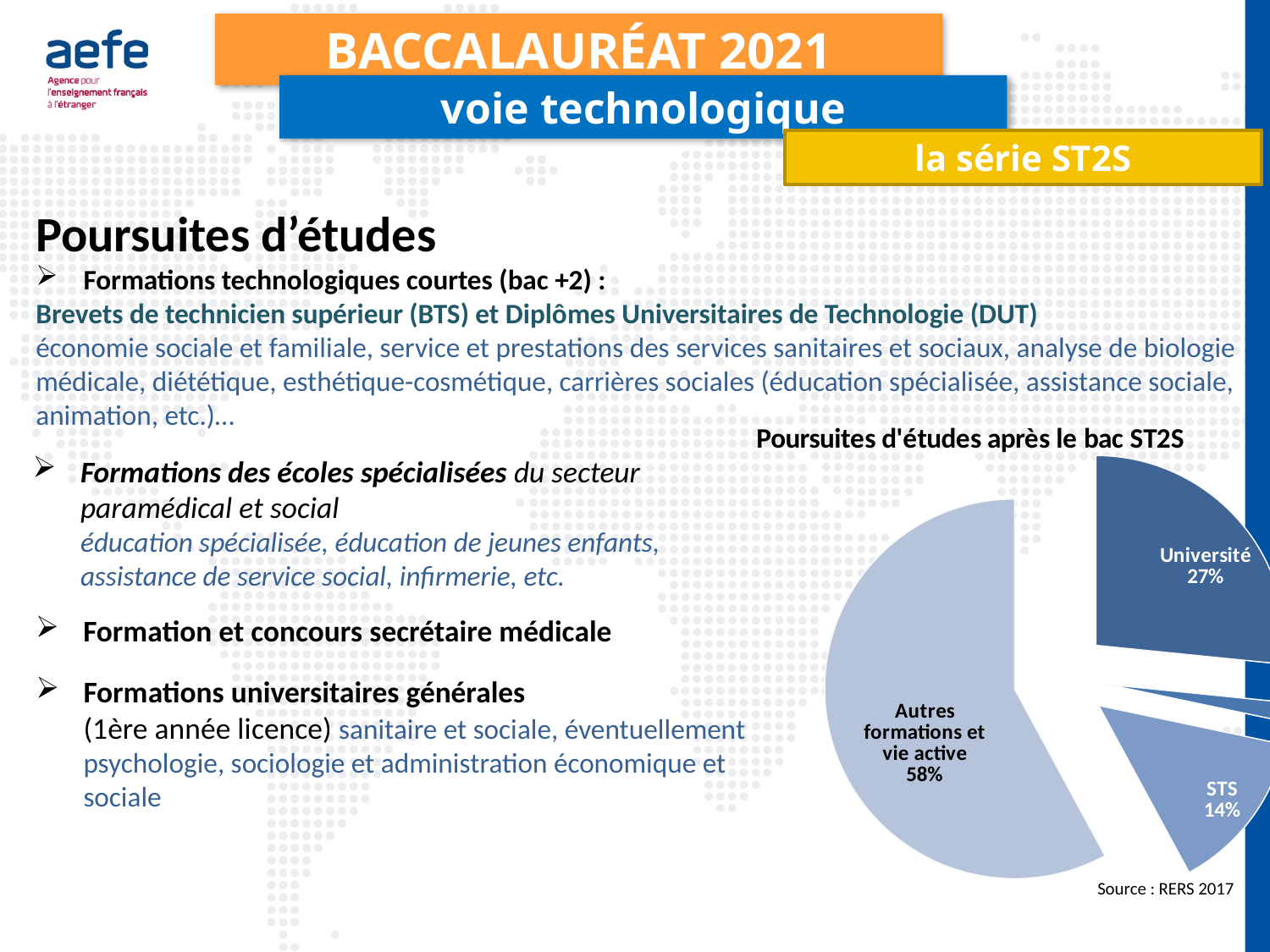
In the pie chart, what share is labelled for STS? 14% What source is cited below the pie chart? RERS 2017 In the pie chart, what is the difference in percentage points between "Autres formations et vie active" and Université? 31 What kind of chart is shown under the title "Poursuites d'études après le bac ST2S"? pie chart In the pie chart, what share is labelled for Université? 27% What is the title of the pie chart on the slide? Poursuites d'études après le bac ST2S In the pie chart, is the share for Université greater or less than 50%? less Which labelled slice of the pie chart is the largest? Autres formations et vie active In the pie chart, what is the difference in percentage points between the Université share and the STS share? 13 Which labelled slice of the pie chart is the smallest? STS In the pie chart, what share is labelled for "Autres formations et vie active"? 58% In the pie chart, which is larger: the share for Université or the share for STS? Université